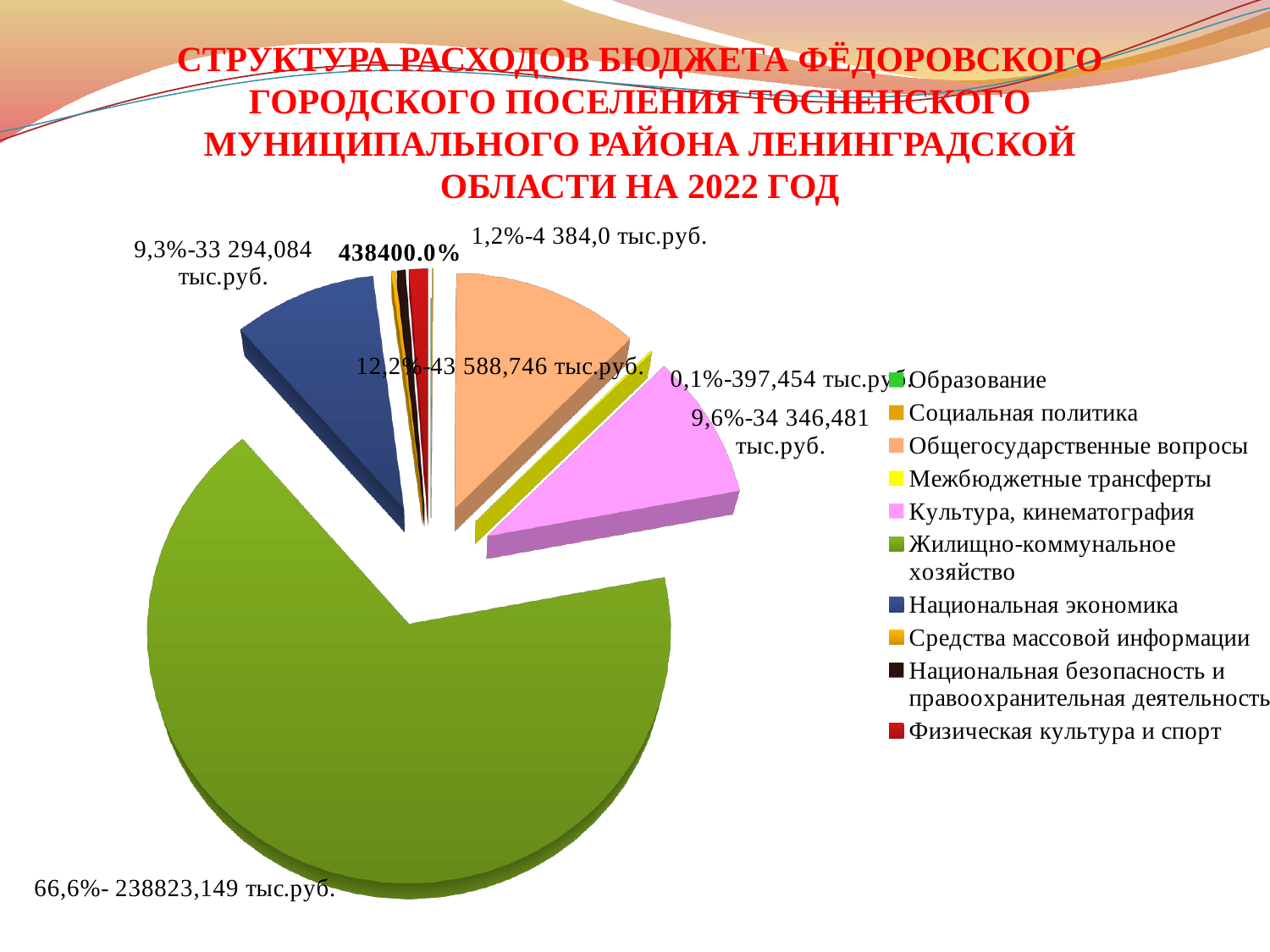
What share of the pie is Межбюджетные трансферты? 0,1% What share of the budget expenditures goes to Жилищно-коммунальное хозяйство? 66,6% How many categories does the legend of the pie chart list? 10 What colour is the slice for Жилищно-коммунальное хозяйство? green Which category has the largest slice of the pie chart? Жилищно-коммунальное хозяйство What share of the pie is Национальная экономика? 9,3% What is the difference in percentage points between the shares of Жилищно-коммунальное хозяйство and Общегосударственные вопросы? 54,4% What amount is shown for Культура, кинематография? 34 346,481 тыс.руб. Which is larger: the share for Культура, кинематография or the share for Национальная экономика? Культура, кинематография What amount in тыс.руб. is shown for Жилищно-коммунальное хозяйство? 238823,149 тыс.руб. What kind of chart is shown on the slide? pie chart